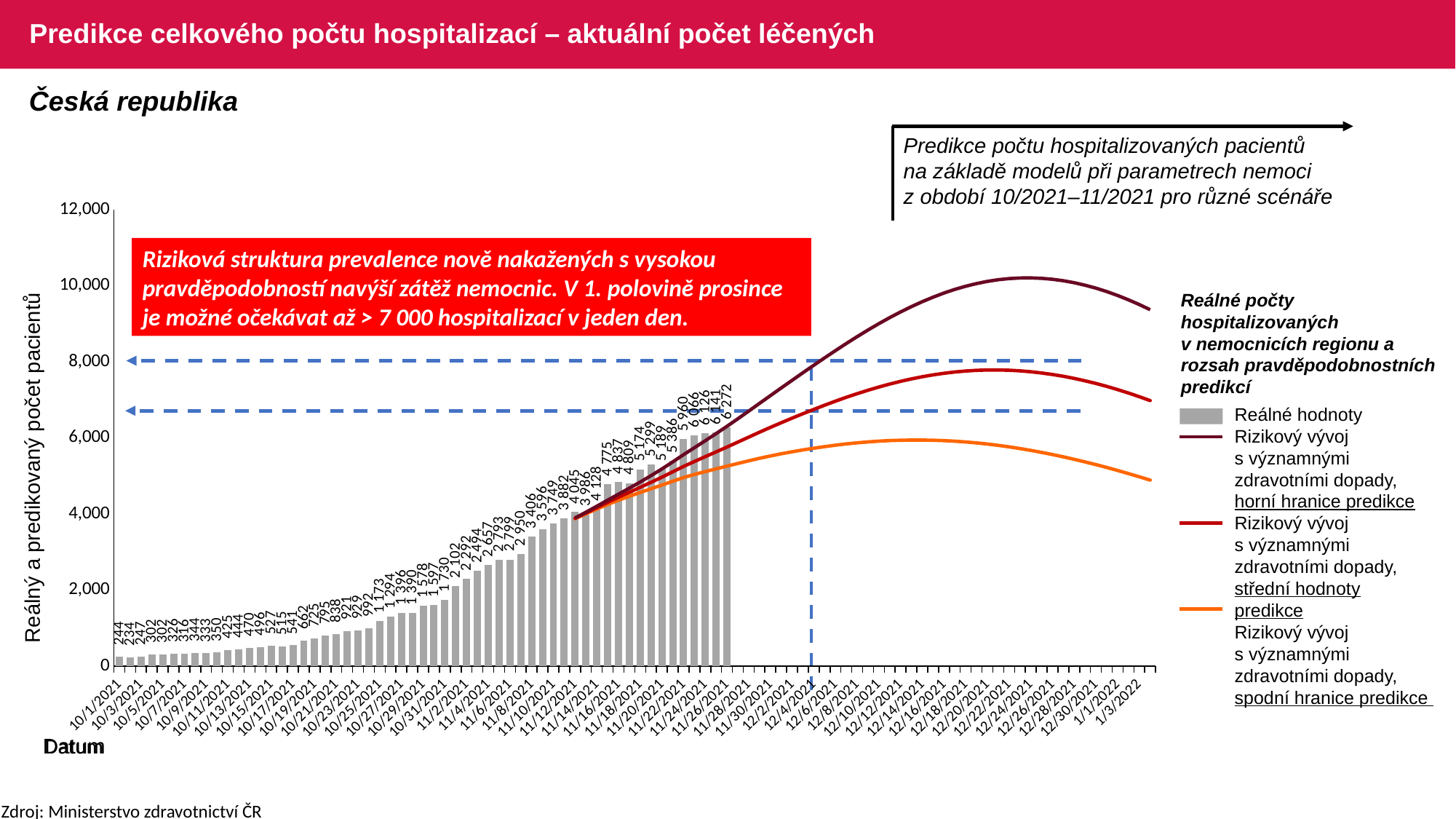
Is the peak of the upper prediction line (horní hranice predikce) greater or less than 8,000? greater What is the label of the vertical axis? Reálný a predikovaný počet pacientů How many series does the chart legend list? 4 What is the value of the first bar, for 10/1/2021? 244 What is the lowest value among the real-value bars? 234 Do the real hospitalization values rise or fall from 10/1/2021 to the end of November 2021? rise Which is larger: the bar for 10/1/2021 or the last bar of real values? The last bar of real values What kind of chart is shown on the slide? A combined bar and line chart Which bar has the highest real value, and what is it? The last bar, 6 272 Is the peak of the lower prediction line (spodní hranice predikce) greater or less than 8,000? less What is the value of the last (most recent) bar of real values? 6 272 What is the difference between the last bar (6 272) and the first bar (244)? 6 028